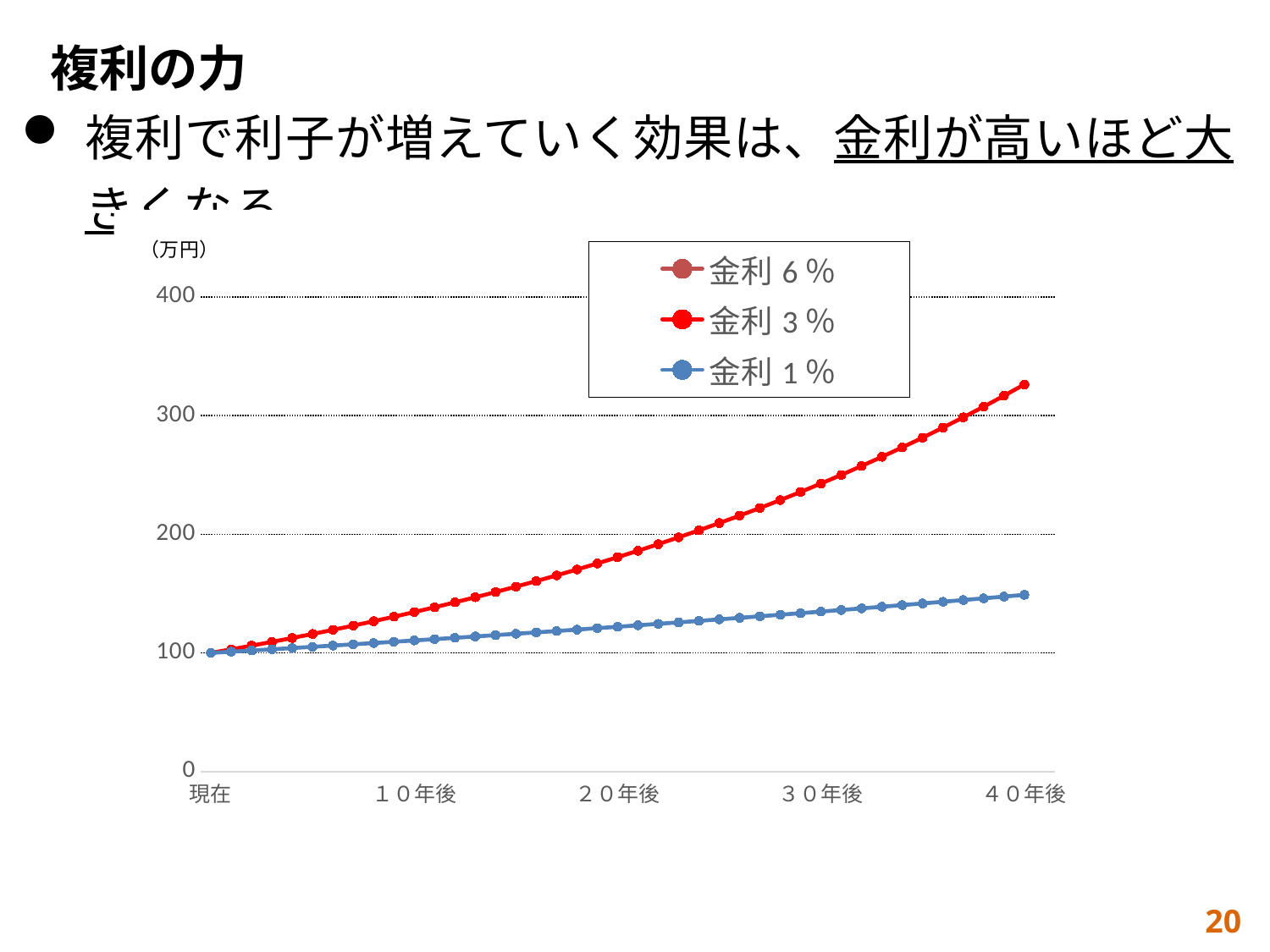
Is the value of the 金利３％ series at ４０年後 greater or less than 300? greater Is the value of the 金利３％ series at ３０年後 greater or less than 200? greater Is the value of the 金利１％ series at ４０年後 greater or less than 200? less What is the value of the 金利３％ series at 現在? 100 What colour is the line for the 金利１％ series? blue What kind of chart is shown on the slide? line chart At ４０年後, which series has the higher value, 金利３％ or 金利１％? 金利３％ How many series does the chart legend list? 3 Do the values of the 金利３％ series rise or fall from 現在 to ４０年後? rise What is the value of the 金利１％ series at 現在? 100 What unit is shown at the top of the vertical axis? 万円